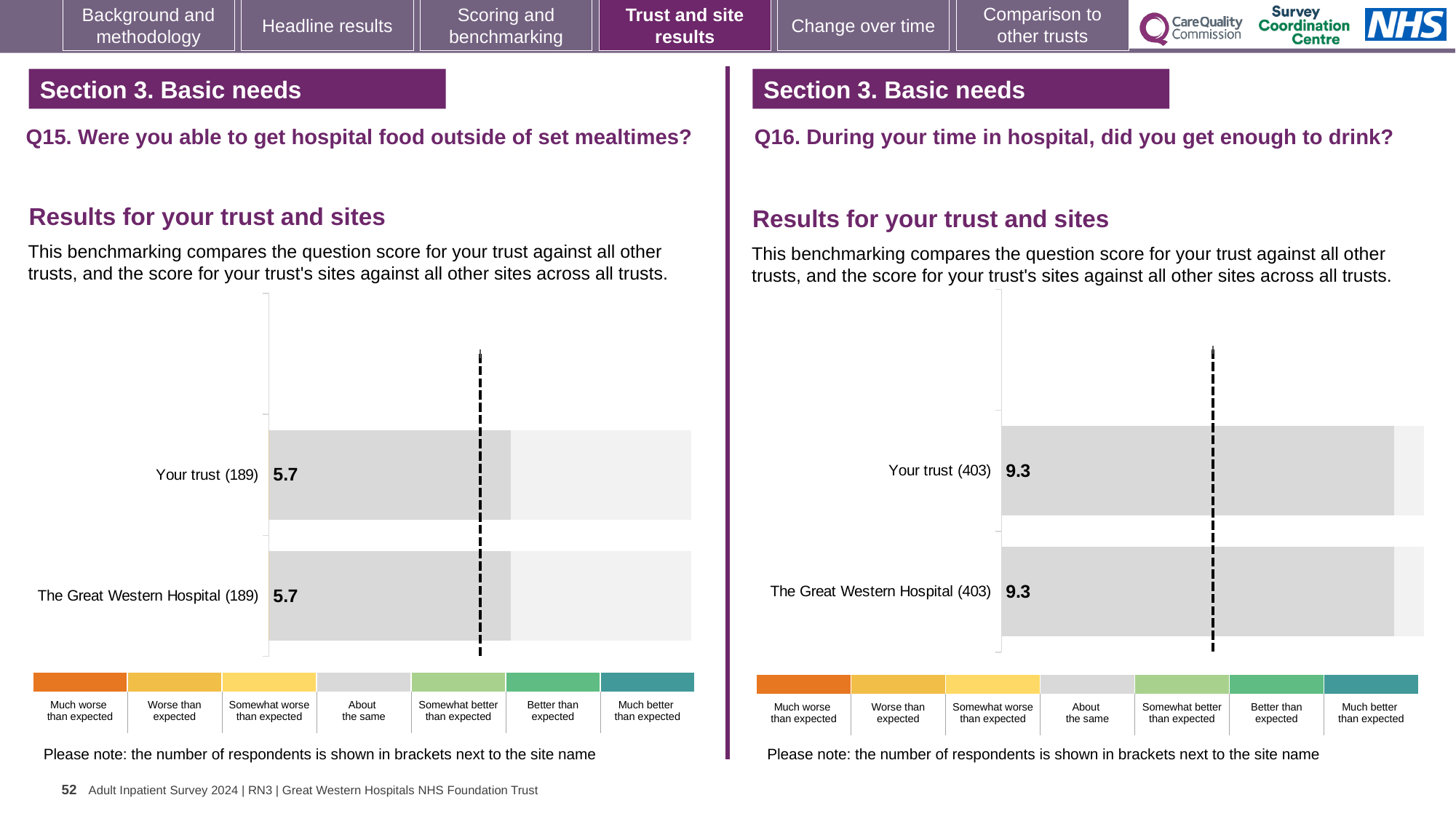
In the Q15 chart on the left, how many bars are plotted? 2 In the Q16 chart on the right, what is the score for The Great Western Hospital? 9.3 In the Q15 chart on the left, what is the difference between the score for Your trust and the score for The Great Western Hospital? 0 What kind of chart is the Q16 chart on the right? Bar chart In the Q16 chart on the right, what is the score for Your trust? 9.3 What kind of chart is the Q15 chart on the left? Bar chart In the Q15 chart on the left, what is the score for The Great Western Hospital? 5.7 In the Q16 chart on the right, how many bars are plotted? 2 In the Q16 chart on the right, how many respondents are shown in brackets next to Your trust? 403 In the Q15 chart on the left, what is the score for Your trust? 5.7 In the Q15 chart on the left, how many respondents are shown in brackets next to The Great Western Hospital? 189